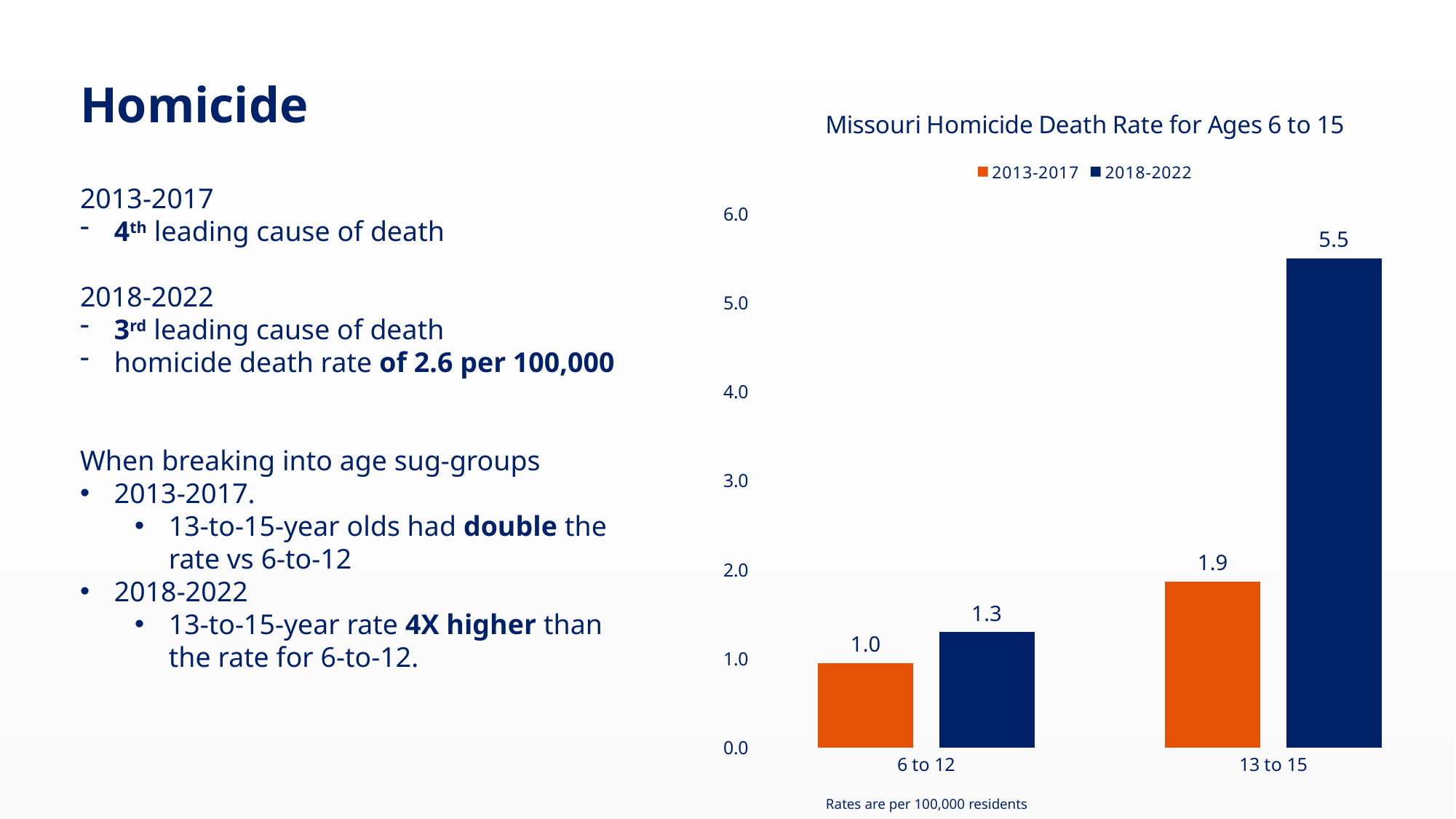
What is the homicide death rate for ages 13 to 15 in 2018-2022? 5.5 Which age group has the highest homicide death rate in 2018-2022? 13 to 15 What type of chart is shown on the slide? Bar chart What is the difference between the 2018-2022 and 2013-2017 homicide death rates for ages 13 to 15? 3.6 How many age groups are shown on the x axis of the chart? 2 What is the homicide death rate for ages 6 to 12 in 2013-2017? 1.0 Is the 2018-2022 homicide death rate for ages 13 to 15 greater or less than 5.0? greater How many series does the chart legend list? 2 What is the homicide death rate for ages 6 to 12 in 2018-2022? 1.3 Which age group has the lowest homicide death rate in 2013-2017? 6 to 12 What is the homicide death rate for ages 13 to 15 in 2013-2017? 1.9 Which is larger: the 2018-2022 rate for ages 6 to 12 or the 2013-2017 rate for ages 13 to 15? 2013-2017 rate for ages 13 to 15